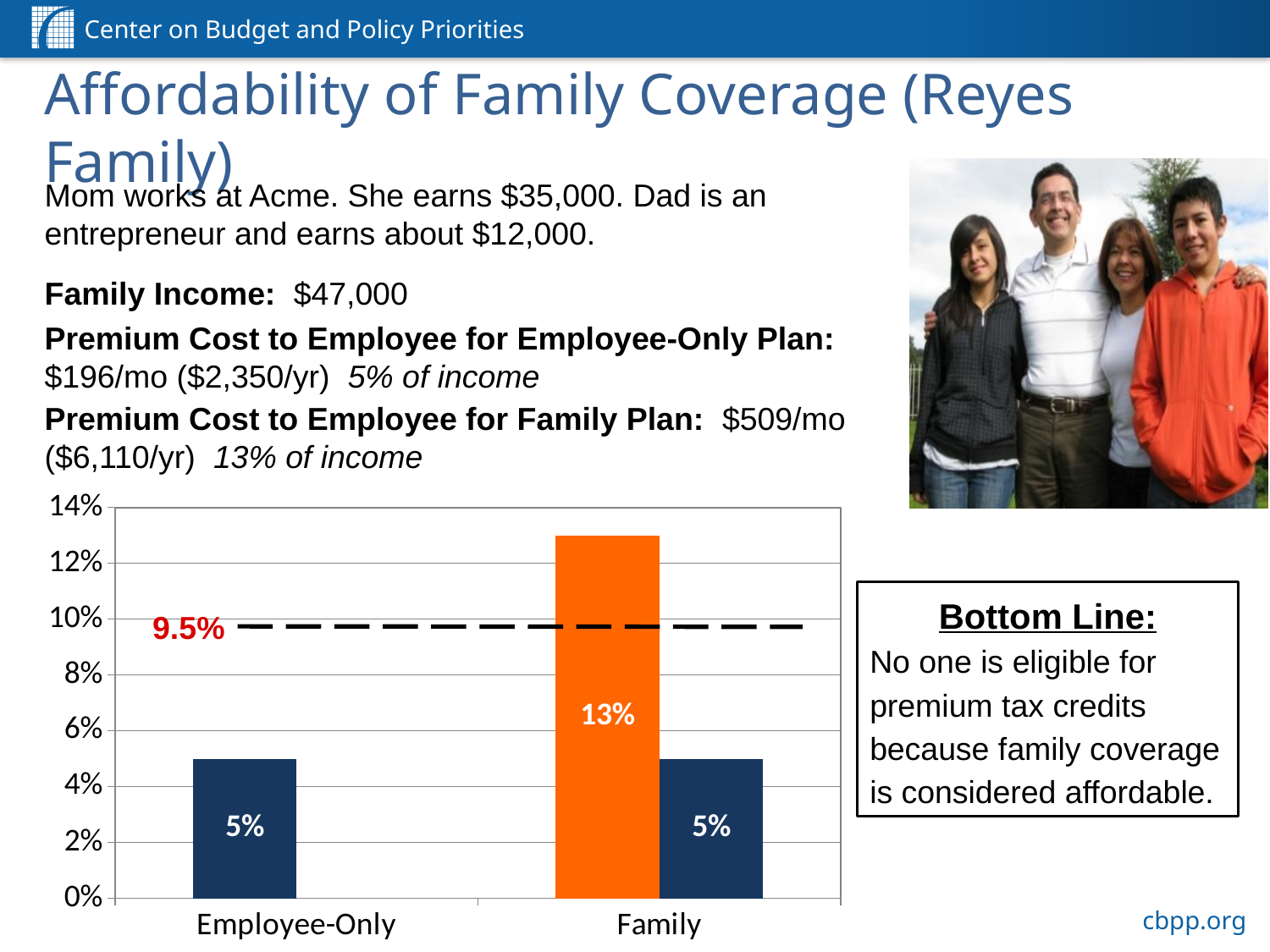
Which bar in the chart is the highest? the orange Family bar (13%) Is the value of the orange Family bar greater or less than 12%? greater What is the value of the orange bar for Family? 13% What is the maximum value shown on the y axis of the chart? 14% What is the value of the dark blue bar for Employee-Only? 5% What type of chart is shown on the slide? bar chart How many categories are shown on the x axis of the chart? 2 Which is larger, the orange Family bar or the Employee-Only bar? the orange Family bar Is the value of the Employee-Only bar greater or less than 6%? less What value is labeled on the dashed horizontal line in the chart? 9.5% What is the difference between the orange Family bar and the dark blue Family bar? 8% What is the value of the dark blue bar for Family? 5%